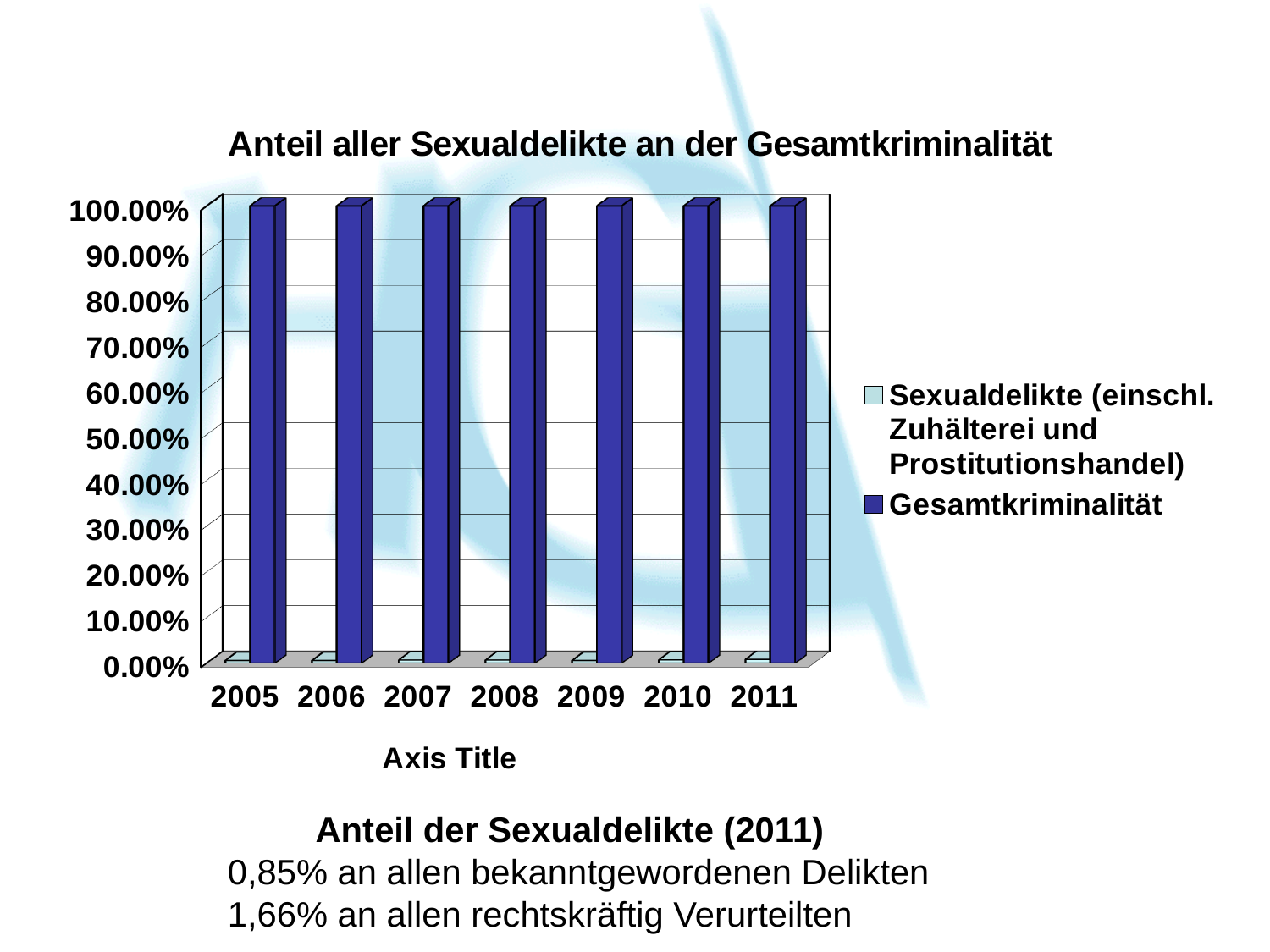
Which years are shown on the x axis of the chart? 2005, 2006, 2007, 2008, 2009, 2010, 2011 Which series has the larger value in 2009, Sexualdelikte (einschl. Zuhälterei und Prostitutionshandel) or Gesamtkriminalität? Gesamtkriminalität What is the title of the chart? Anteil aller Sexualdelikte an der Gesamtkriminalität Is the value for Sexualdelikte (einschl. Zuhälterei und Prostitutionshandel) in 2011 greater or less than 10.00%? less How many years are shown on the x axis of the chart? 7 How many series does the legend list? 2 What kind of chart is shown on the slide? bar chart What value does the Gesamtkriminalität bar reach in 2011? 100.00% Do the Gesamtkriminalität values rise, fall, or stay the same from 2005 to 2011? stay the same Is the value for Gesamtkriminalität in 2008 greater or less than 90.00%? greater What value does the Gesamtkriminalität bar reach in 2005? 100.00% Is the value for Sexualdelikte (einschl. Zuhälterei und Prostitutionshandel) in 2005 greater or less than 10.00%? less